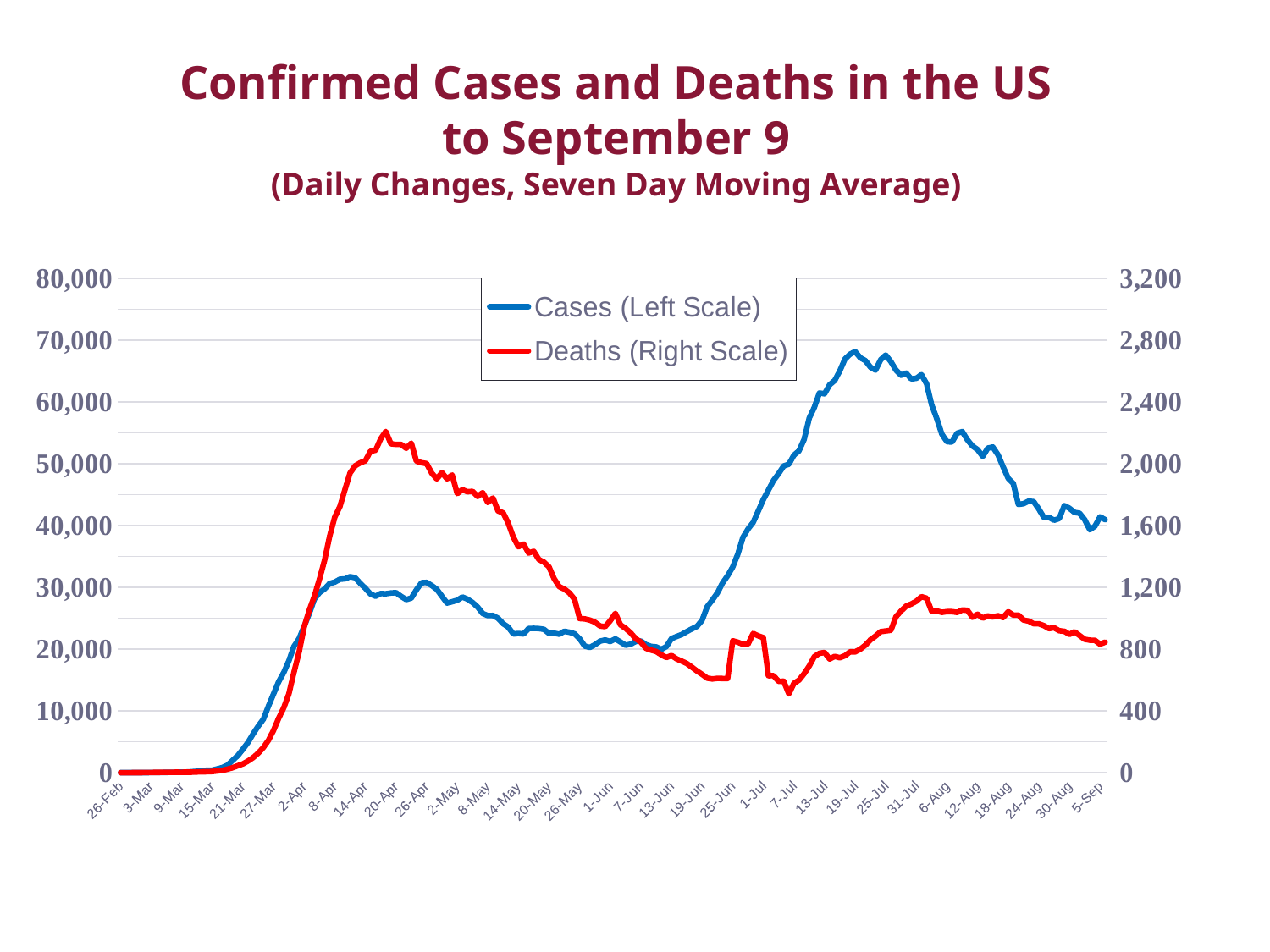
Do the values of the Deaths series rise or fall between 7-Jul and 31-Jul? rise Do the values of the Cases series rise or fall between 19-Jul and 5-Sep? fall What kind of chart is shown on the slide? line chart Is the peak value of the Deaths series around 20-Apr greater or less than 2,000? greater Is the value of the Cases series at 5-Sep greater or less than 50,000? less What colour is the Cases (Left Scale) line? blue Is the value of the Cases series at 5-Sep greater or less than 30,000? greater Which series is plotted against the right scale? Deaths How many series does the legend list? 2